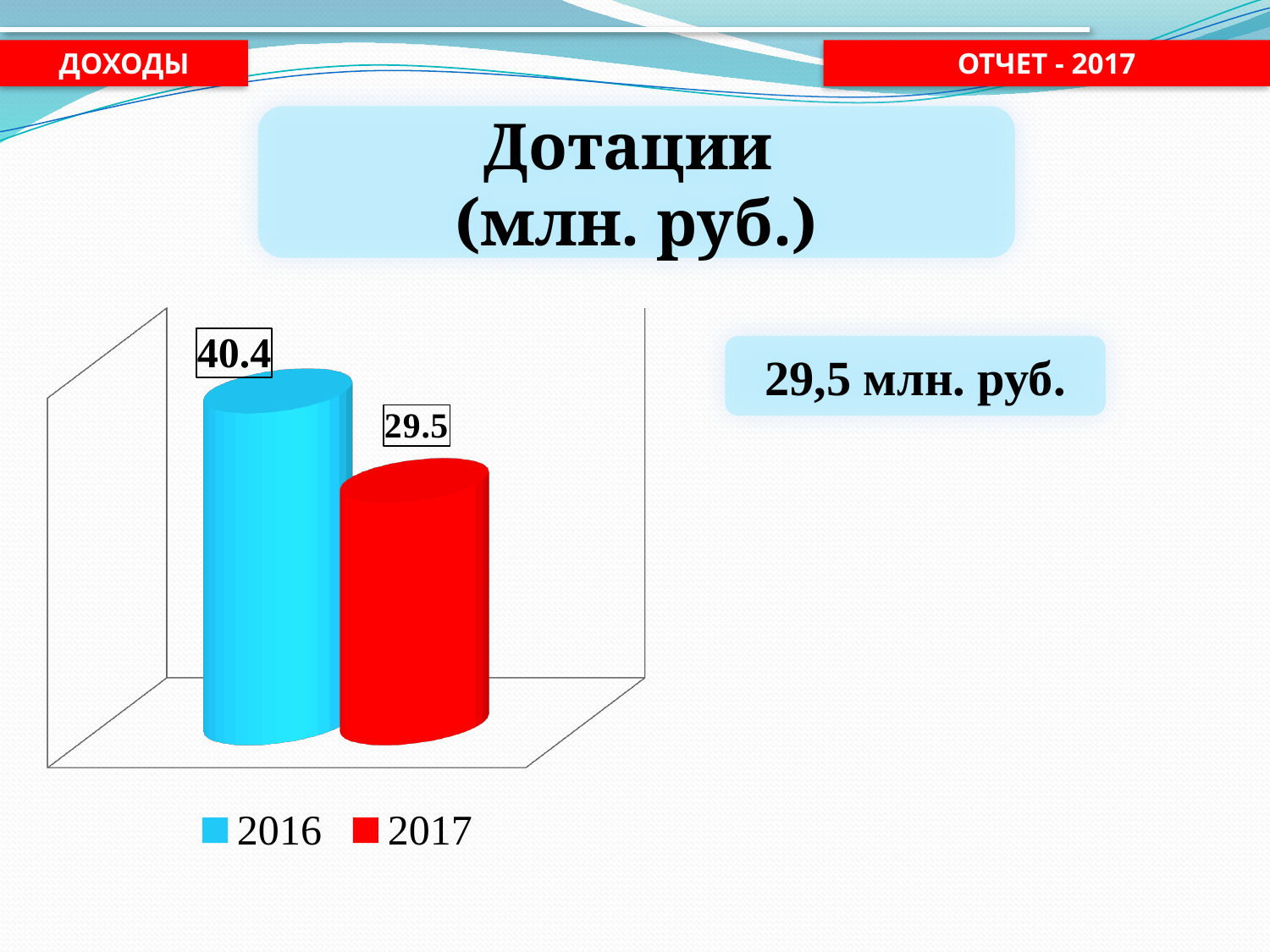
What is the value for 2016? 40.4 How many bars are plotted in the chart? 2 What unit is given in the chart title? млн. руб. What colour is the bar for 2017? red What is the value for 2017? 29.5 How many series does the legend list? 2 Is the value for 2016 larger or smaller than the value for 2017? larger Which year has the higher value? 2016 Which year has the lower value? 2017 What is the difference between the 2016 and 2017 values? 10.9 What kind of chart is shown on the slide? bar chart Do the values rise or fall from 2016 to 2017? fall